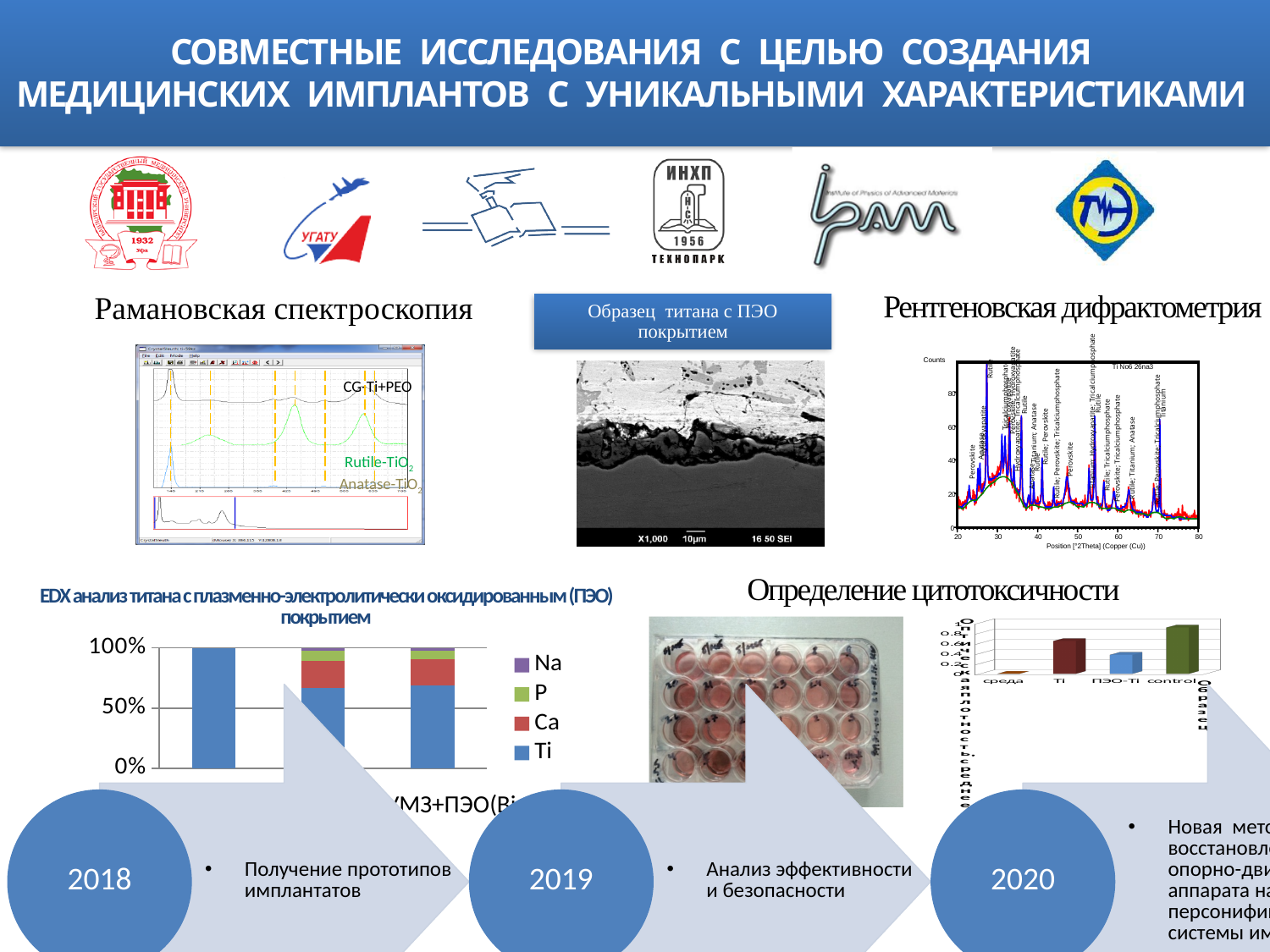
In the cytotoxicity chart (Определение цитотоксичности) at the bottom right, how many categories are shown on the horizontal axis? 4 In the EDX analysis chart at the bottom left, how many bars are plotted? 3 In the EDX analysis chart at the bottom left, how many series does the legend list? 4 In the cytotoxicity chart at the bottom right, which bar is taller: Ti or ПЭО-Ti? Ti In the cytotoxicity chart at the bottom right, is the value for ПЭО-Ti greater or less than 0.6? less In the EDX analysis chart at the bottom left, which elements are listed in the legend? Na, P, Ca, Ti In the X-ray diffractometry chart (Рентгеновская дифрактометрия), what is the label of the horizontal axis? Position [°2Theta] (Copper (Cu)) In the EDX analysis chart at the bottom left, what is the highest value shown on the vertical axis? 100% In the EDX analysis chart at the bottom left, which element makes up the largest share of every bar? Ti In the cytotoxicity chart at the bottom right, which category has the lowest bar? среда What kind of chart is the EDX analysis chart at the bottom left? Stacked bar chart In the cytotoxicity chart at the bottom right, which category has the highest bar? control